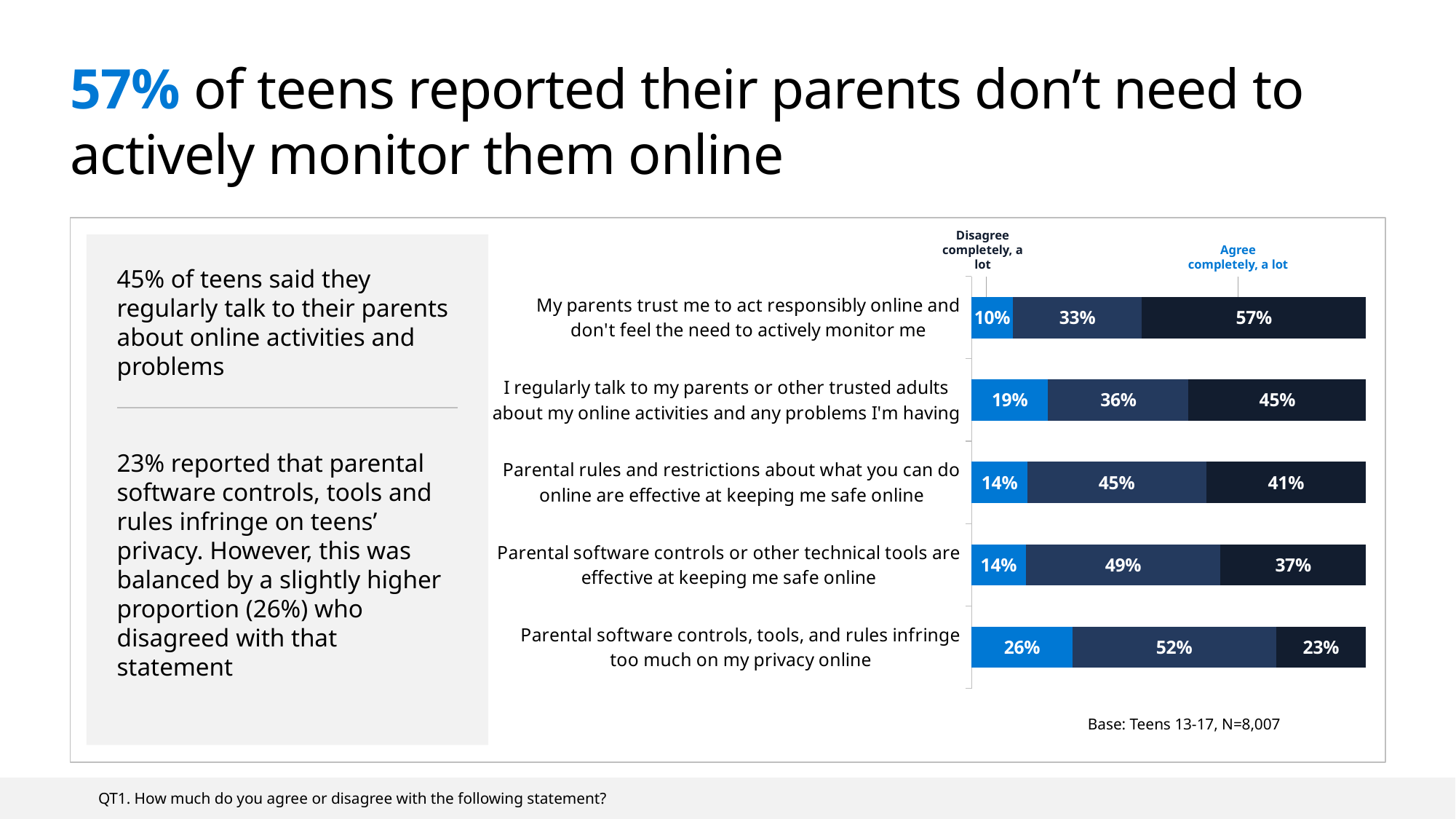
What type of chart is shown on the slide? Stacked bar chart Which is larger: the 'Disagree completely, a lot' share for 'I regularly talk to my parents or other trusted adults...' or for 'Parental rules and restrictions... are effective at keeping me safe online'? I regularly talk to my parents or other trusted adults about my online activities and any problems I'm having Which statement has the lowest 'Disagree completely, a lot' percentage? My parents trust me to act responsibly online and don't feel the need to actively monitor me What percentage of teens agree completely or a lot that their parents trust them to act responsibly online and don't feel the need to actively monitor them? 57% Which statement has the highest 'Agree completely, a lot' percentage? My parents trust me to act responsibly online and don't feel the need to actively monitor me What is the difference between the 'Agree completely, a lot' percentages for 'My parents trust me to act responsibly online...' and 'I regularly talk to my parents or other trusted adults...'? 12% What is the total of the three segments for the statement 'Parental software controls, tools, and rules infringe too much on my privacy online'? 101% How many statements are shown in the chart? 5 What base is stated below the chart? Teens 13-17, N=8,007 What percentage of teens disagree completely or a lot with the statement 'Parental software controls, tools, and rules infringe too much on my privacy online'? 26% What is the middle segment value for the statement 'Parental software controls or other technical tools are effective at keeping me safe online'? 49% What percentage of teens agree completely or a lot that parental rules and restrictions about what they can do online are effective at keeping them safe? 41%